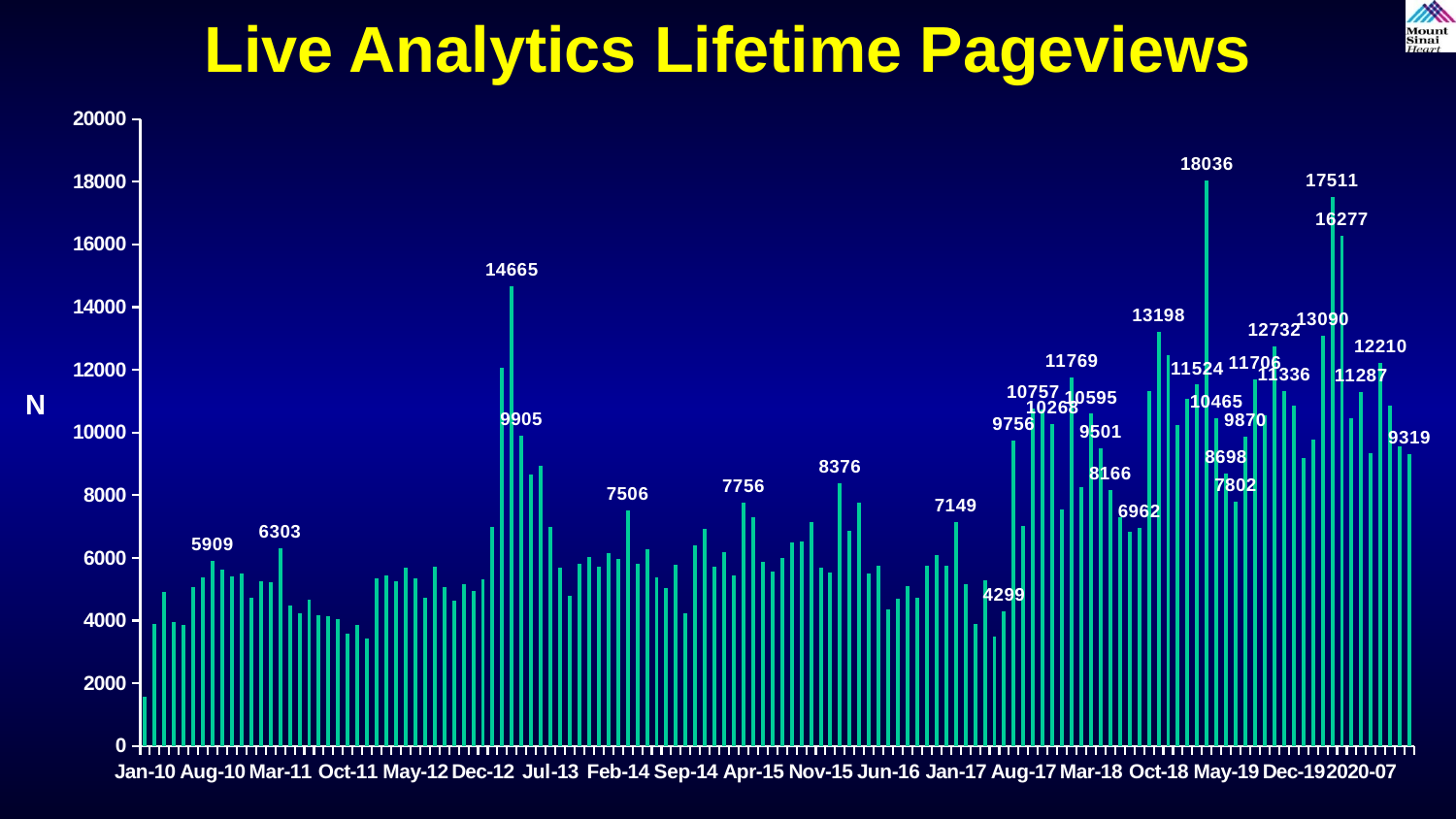
What is the highest tick value shown on the vertical axis? 20000 What is the lowest value labeled on the chart? 4299 What label is shown on the vertical axis of the chart? N What is the difference between the labeled values 17511 and 16277? 1234 What is the title of the chart? Live Analytics Lifetime Pageviews What kind of chart is shown on the slide? bar chart What is the highest value labeled on the chart? 18036 What is the difference between the two highest labeled values, 18036 and 17511? 525 Which labeled value is larger, 14665 or 13198? 14665 Is the value for Aug-10 greater or less than 4000? greater Do the pageview values generally rise or fall from Jan-10 to 2020? rise Is the value for Jan-10 greater or less than 2000? less